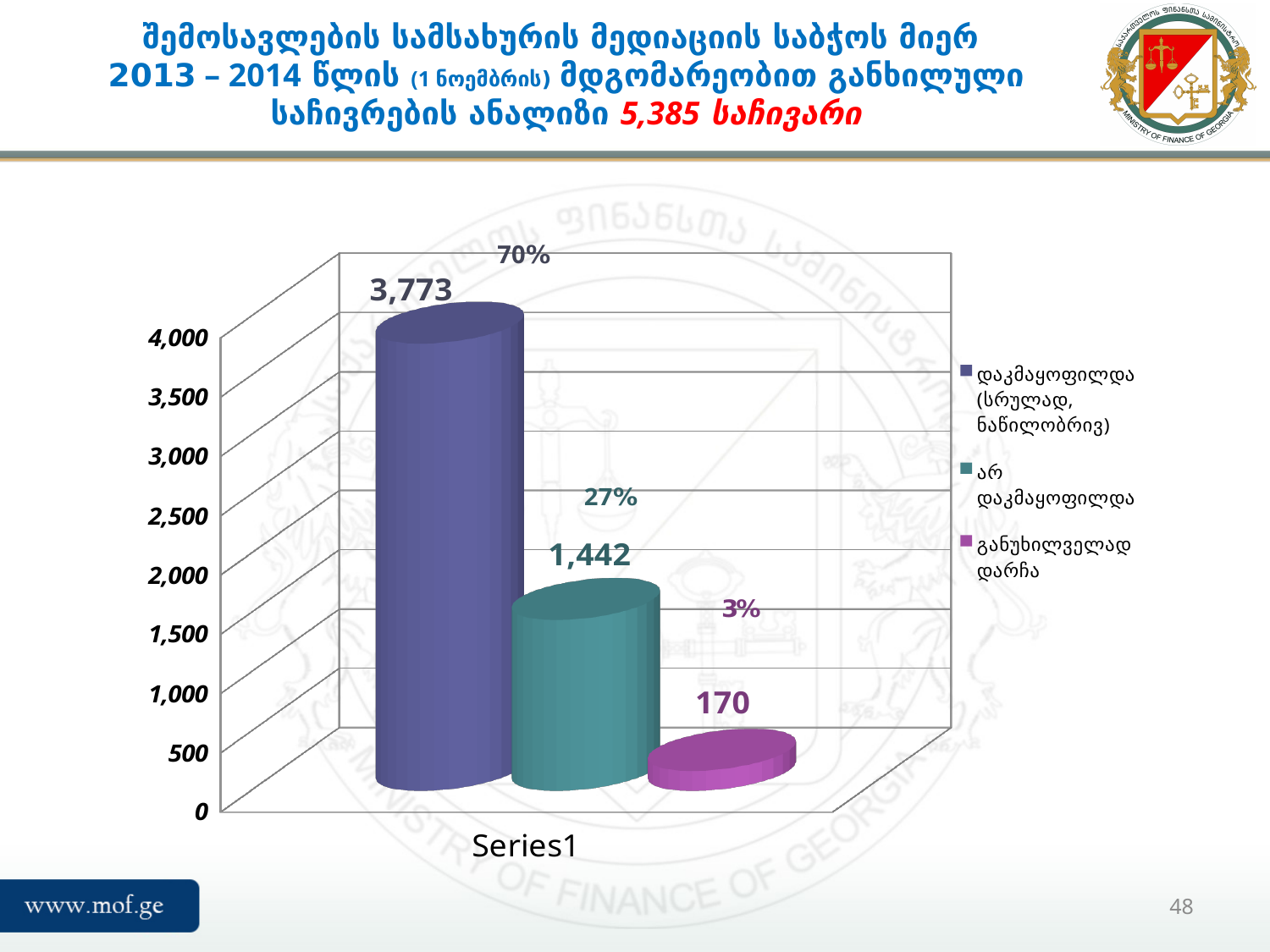
How many entries does the legend list? 3 What is the value for დაკმაყოფილდა (სრულად, ნაწილობრივ)? 3,773 How many bars are plotted in the chart? 3 What is the value for განუხილველად დარჩა? 170 What is the difference between the values for დაკმაყოფილდა (სრულად, ნაწილობრივ) and არ დაკმაყოფილდა? 2,331 What is the value for არ დაკმაყოფილდა? 1,442 What kind of chart is shown on the slide? Bar chart Which is larger, the value for არ დაკმაყოფილდა or the value for განუხილველად დარჩა? არ დაკმაყოფილდა Which category has the lowest value? განუხილველად დარჩა What percentage is shown above the bar for დაკმაყოფილდა (სრულად, ნაწილობრივ)? 70% What percentage is shown above the bar for არ დაკმაყოფილდა? 27% Which category has the highest value? დაკმაყოფილდა (სრულად, ნაწილობრივ)